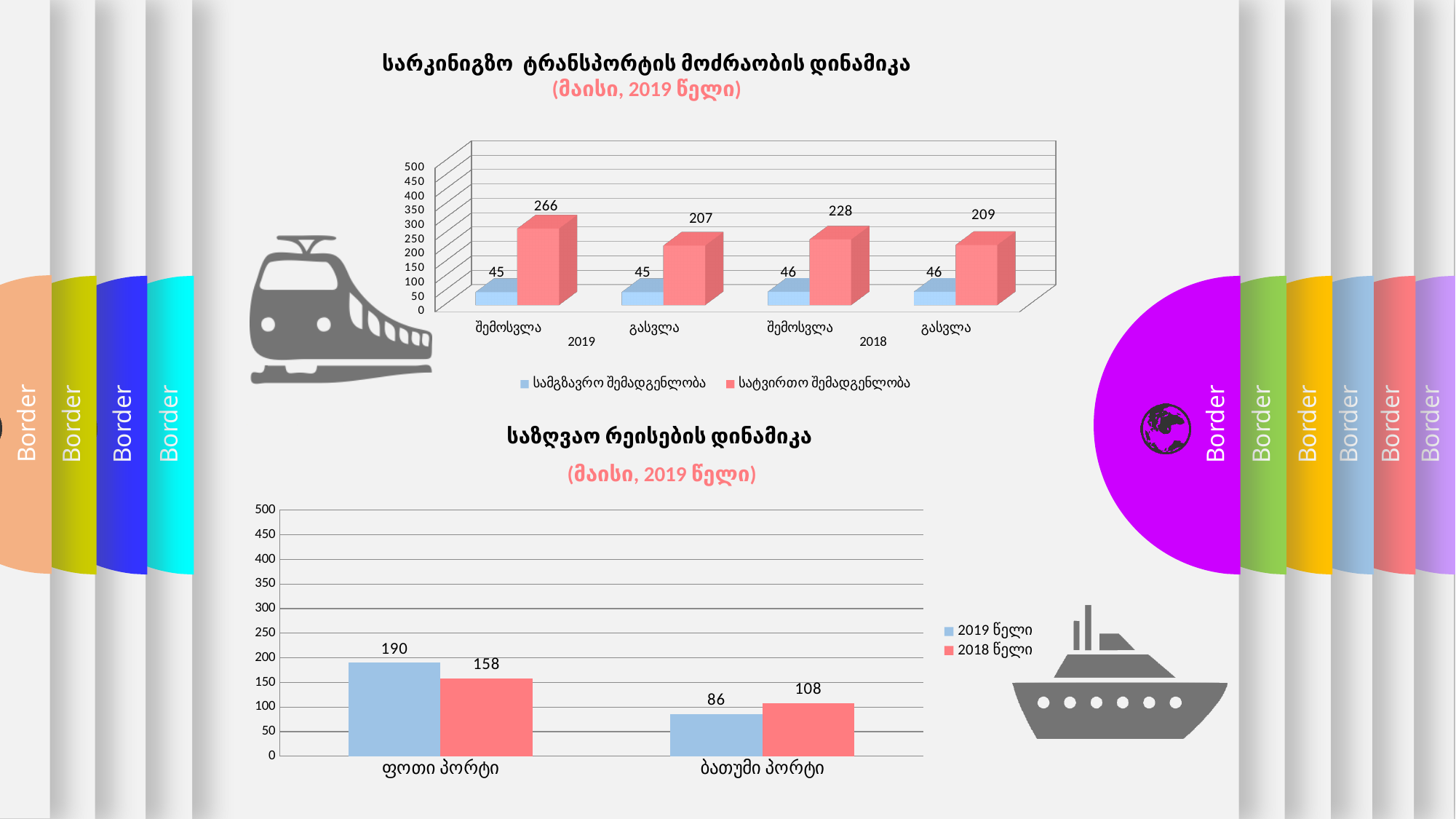
In the bottom chart (საზღვაო რეისების დინამიკა), how many categories are shown on the x axis? 2 In the bottom chart (საზღვაო რეისების დინამიკა), what is the difference between the 2019 წელი and 2018 წელი values for ფოთი პორტი? 32 In the top chart (სარკინიგზო ტრანსპორტის მოძრაობის დინამიკა), how many series does the legend list? 2 In the top chart (სარკინიგზო ტრანსპორტის მოძრაობის დინამიკა), which category has the highest სატვირთო შემადგენლობა value? შემოსვლა 2019 In the bottom chart (საზღვაო რეისების დინამიკა), which is larger for ბათუმი პორტი: the 2019 წელი value or the 2018 წელი value? 2018 წელი What kind of chart is the bottom chart (საზღვაო რეისების დინამიკა)? Bar chart In the top chart (სარკინიგზო ტრანსპორტის მოძრაობის დინამიკა), what is the value of სამგზავრო შემადგენლობა for გასვლა in 2018? 46 In the bottom chart (საზღვაო რეისების დინამიკა), what is the value for ბათუმი პორტი in 2018 წელი? 108 In the bottom chart (საზღვაო რეისების დინამიკა), what is the value for ფოთი პორტი in 2019 წელი? 190 In the top chart (სარკინიგზო ტრანსპორტის მოძრაობის დინამიკა), what is the difference between the სატვირთო შემადგენლობა values for შემოსვლა 2019 and შემოსვლა 2018? 38 In the top chart (სარკინიგზო ტრანსპორტის მოძრაობის დინამიკა), what is the value of სატვირთო შემადგენლობა for შემოსვლა in 2019? 266 In the top chart (სარკინიგზო ტრანსპორტის მოძრაობის დინამიკა), which series is shown in red? სატვირთო შემადგენლობა